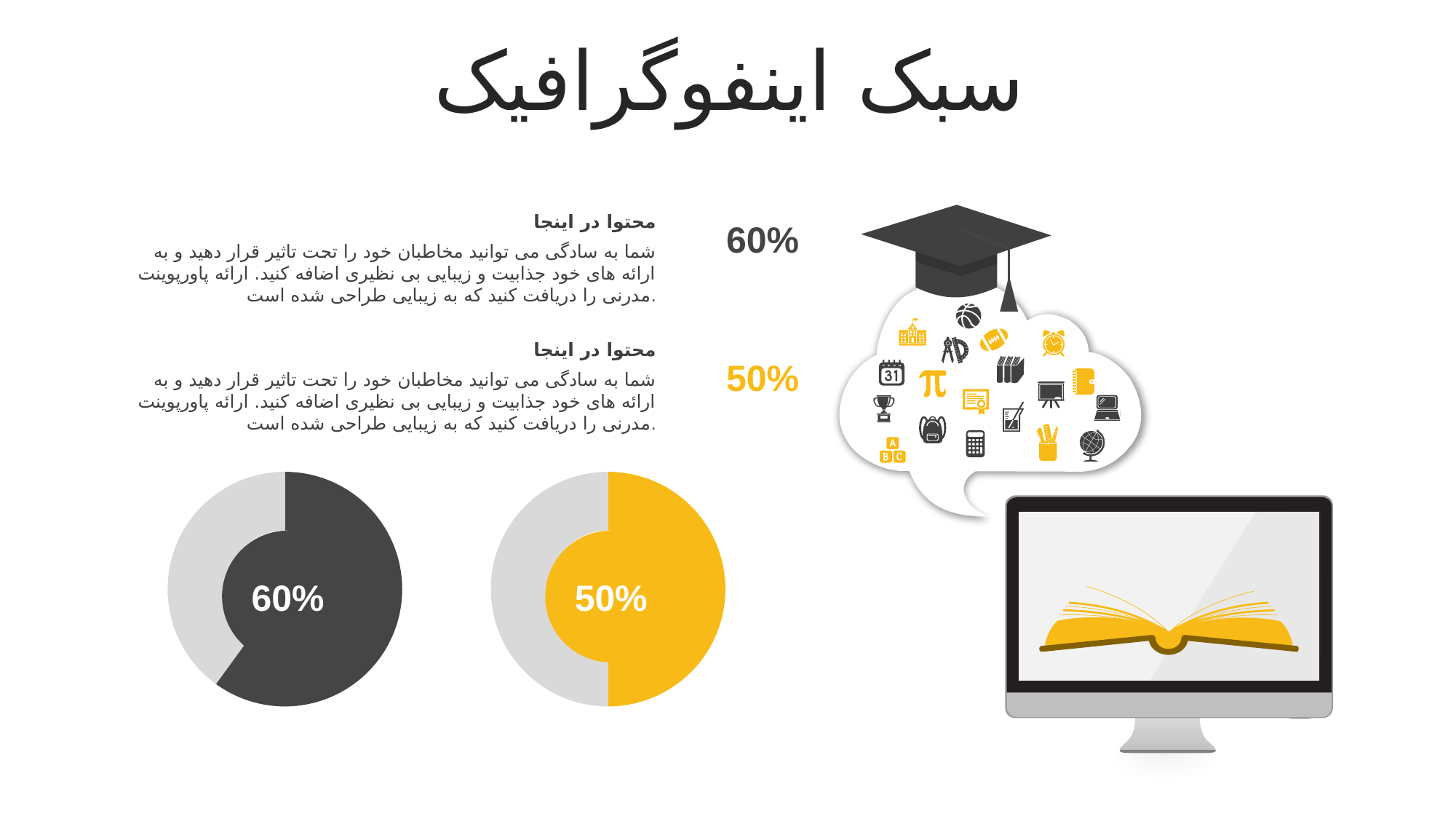
How many pie charts are shown on the slide? 2 Is the value shown on the left (dark grey) pie chart greater or less than 50%? greater What share of the right (yellow) pie chart does the highlighted slice represent? 50% What colour is the highlighted slice of the pie chart showing 60%? dark grey What colour is the highlighted slice of the pie chart showing 50%? yellow Which of the two pie charts shows the larger percentage, the left dark grey one or the right yellow one? the left dark grey one What percentage is shown on the left (dark grey) pie chart? 60% What kind of chart is used to show the 60% and 50% values at the bottom left of the slide? pie chart What share of the left (dark grey) pie chart does the highlighted slice represent? 60% What is the difference between the percentage on the left pie chart and the percentage on the right pie chart? 10% What percentage is shown on the right (yellow) pie chart? 50% Is the value shown on the right (yellow) pie chart greater or less than 60%? less